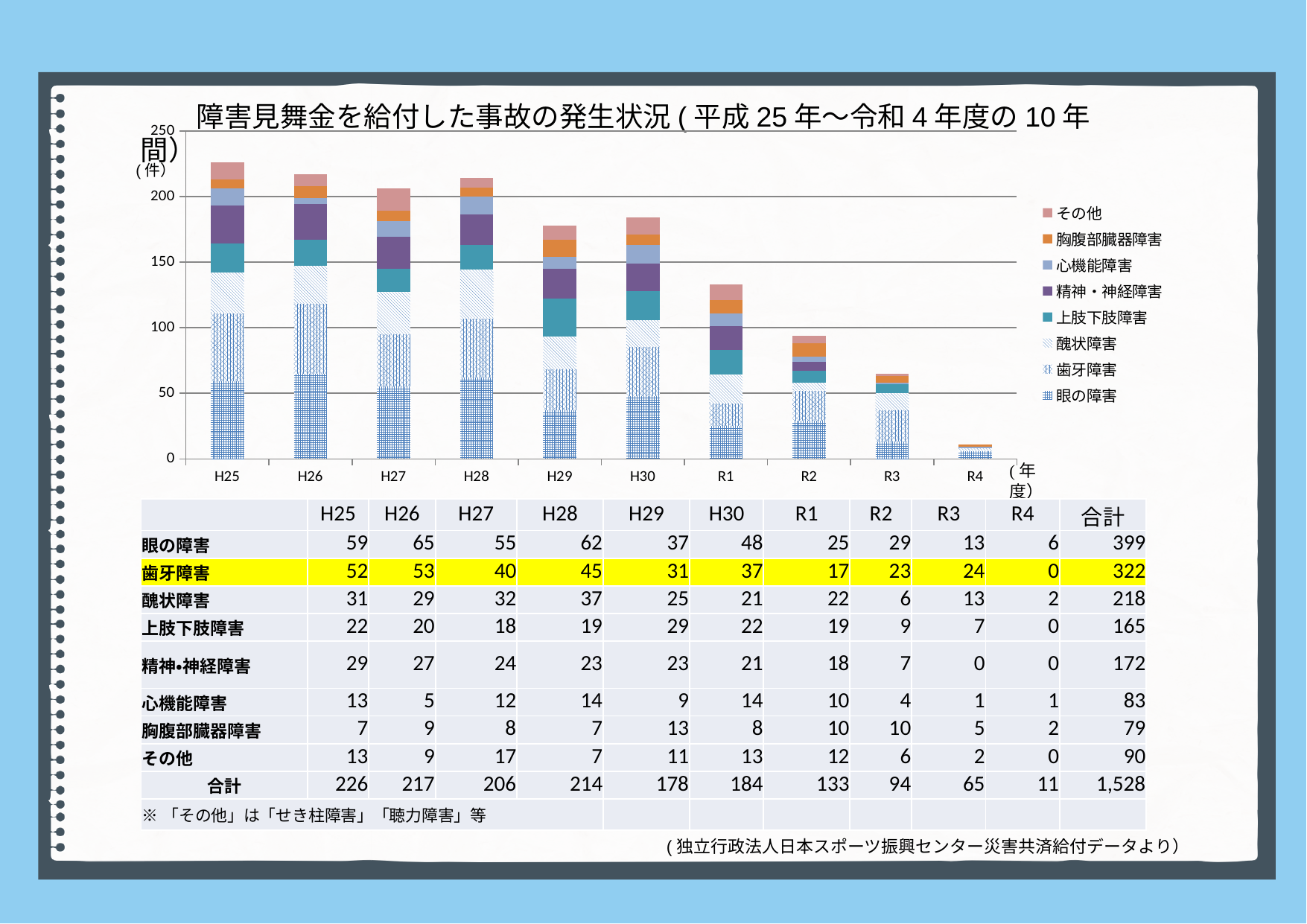
Which has the larger total, H27 or H28? H28 How many series does the chart legend list? 8 What is the difference between the total for H25 and the total for H26? 9 Which fiscal year has the highest total number of cases? H25 Do the total values generally rise or fall from H25 to R4? fall What kind of chart is shown on the slide? stacked bar chart Which fiscal year has the lowest total number of cases? R4 What is the value of 眼の障害 for H25? 59 What is the total (合計) of the stacked bar for H25? 226 What is the total (合計) of the stacked bar for R4? 11 What is the value of 歯牙障害 for R3? 24 How many fiscal-year categories are plotted along the x axis? 10